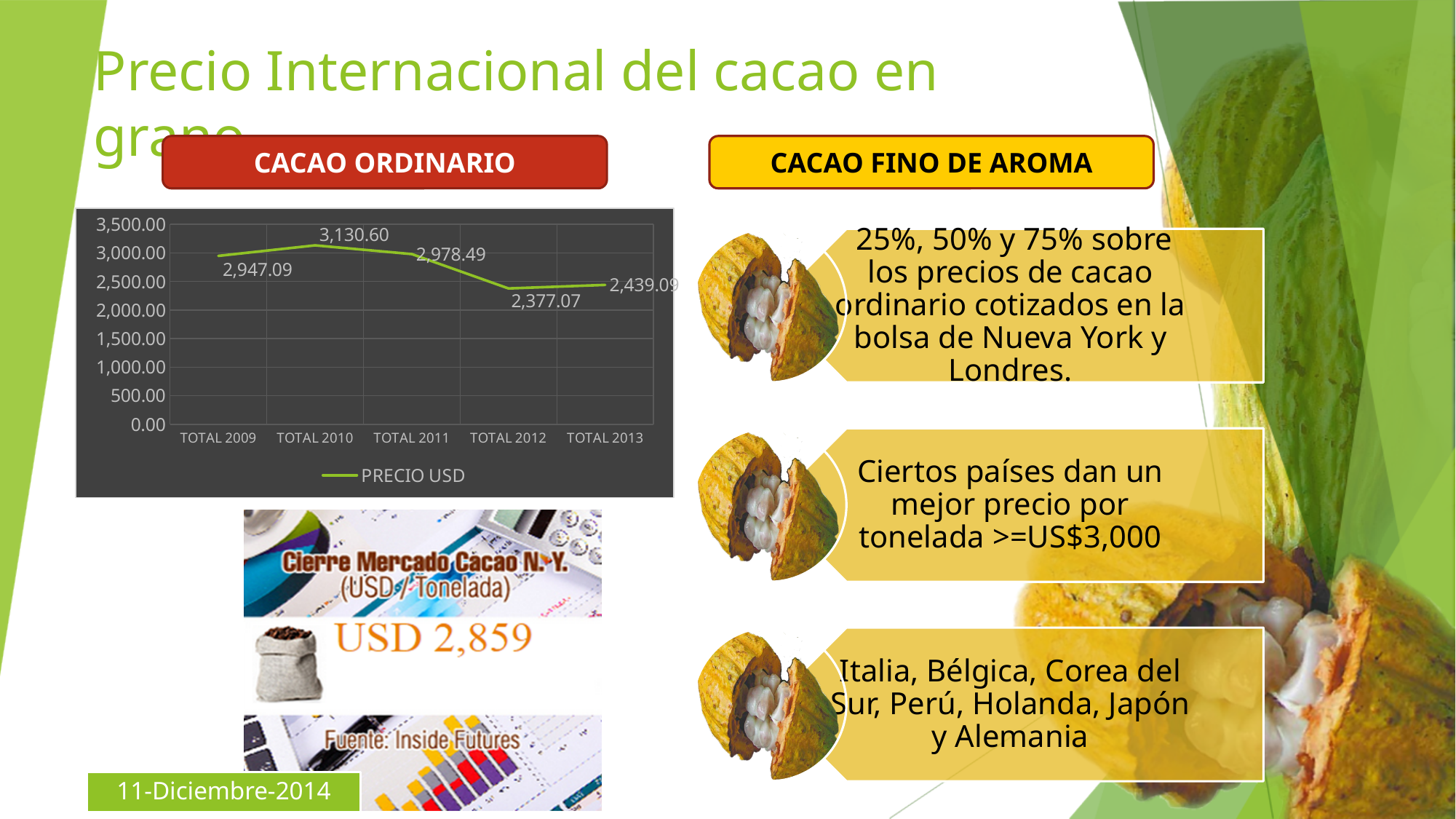
How many categories are shown on the x axis of the chart? 5 Which category has the highest PRECIO USD value? TOTAL 2010 Which category has the lowest PRECIO USD value? TOTAL 2012 What is the name of the series shown in the chart legend? PRECIO USD What is the PRECIO USD value for TOTAL 2010? 3,130.60 What is the difference between the PRECIO USD values for TOTAL 2010 and TOTAL 2012? 753.53 Which is larger, the PRECIO USD value for TOTAL 2011 or for TOTAL 2013? TOTAL 2011 What kind of chart is shown on the slide? line chart Is the PRECIO USD value for TOTAL 2012 greater or less than 2,500.00? less How many series does the chart legend list? 1 What is the PRECIO USD value for TOTAL 2009? 2,947.09 What is the PRECIO USD value for TOTAL 2013? 2,439.09